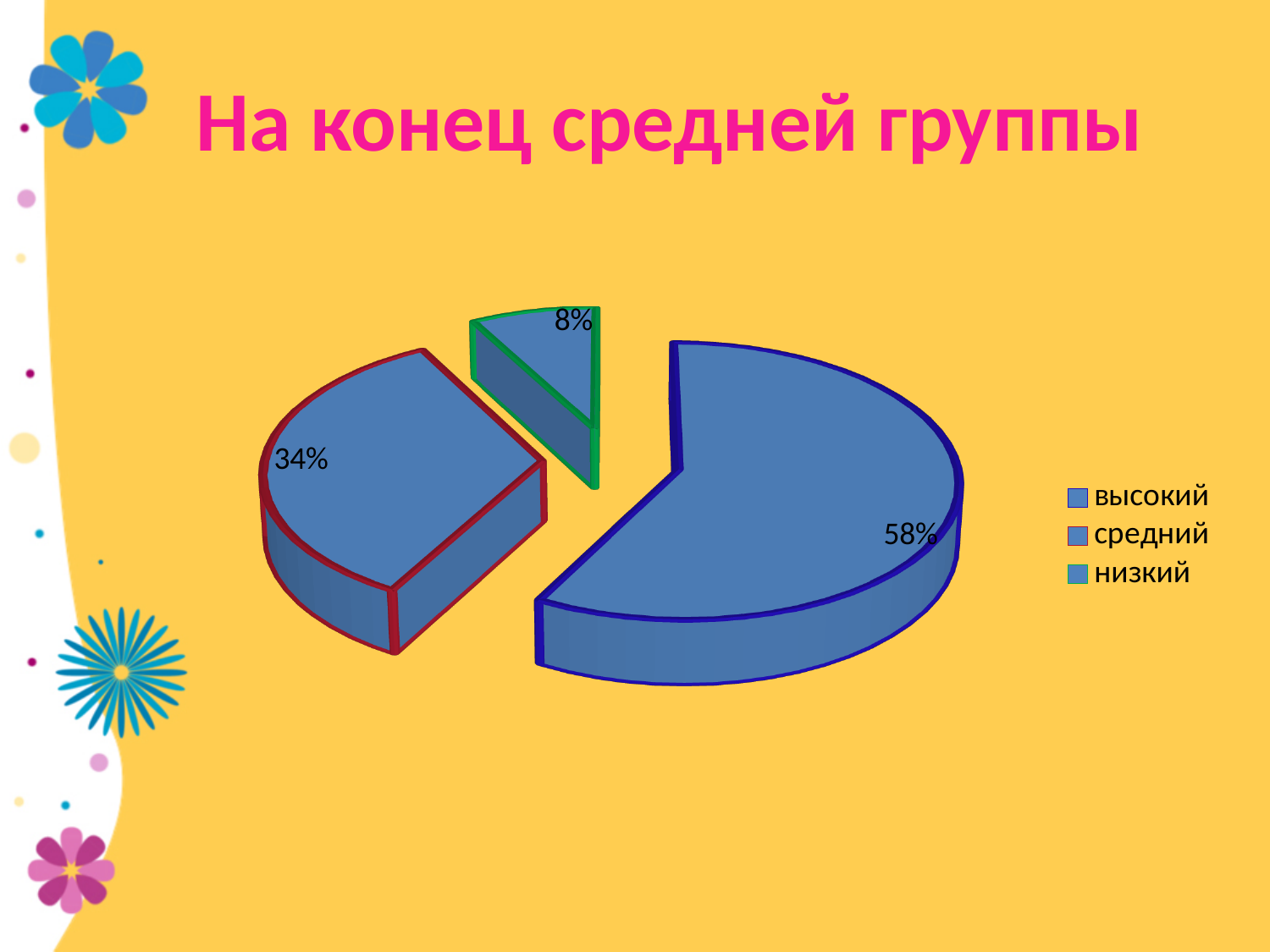
How many slices does the pie chart have? 3 What kind of chart is shown on the slide? pie chart What share of the pie does the 'высокий' slice represent? 58% What share of the pie does the 'средний' slice represent? 34% What is the title of the chart on the slide? На конец средней группы Which is larger, the 'средний' share or the 'низкий' share? средний What is the smallest share shown in the pie chart? 8% What share of the pie does the 'низкий' slice represent? 8% What is the largest share shown in the pie chart? 58% What is the difference between the 'высокий' share and the 'средний' share? 24% How many entries does the chart legend list? 3 Which legend entry is listed first in the chart legend? высокий